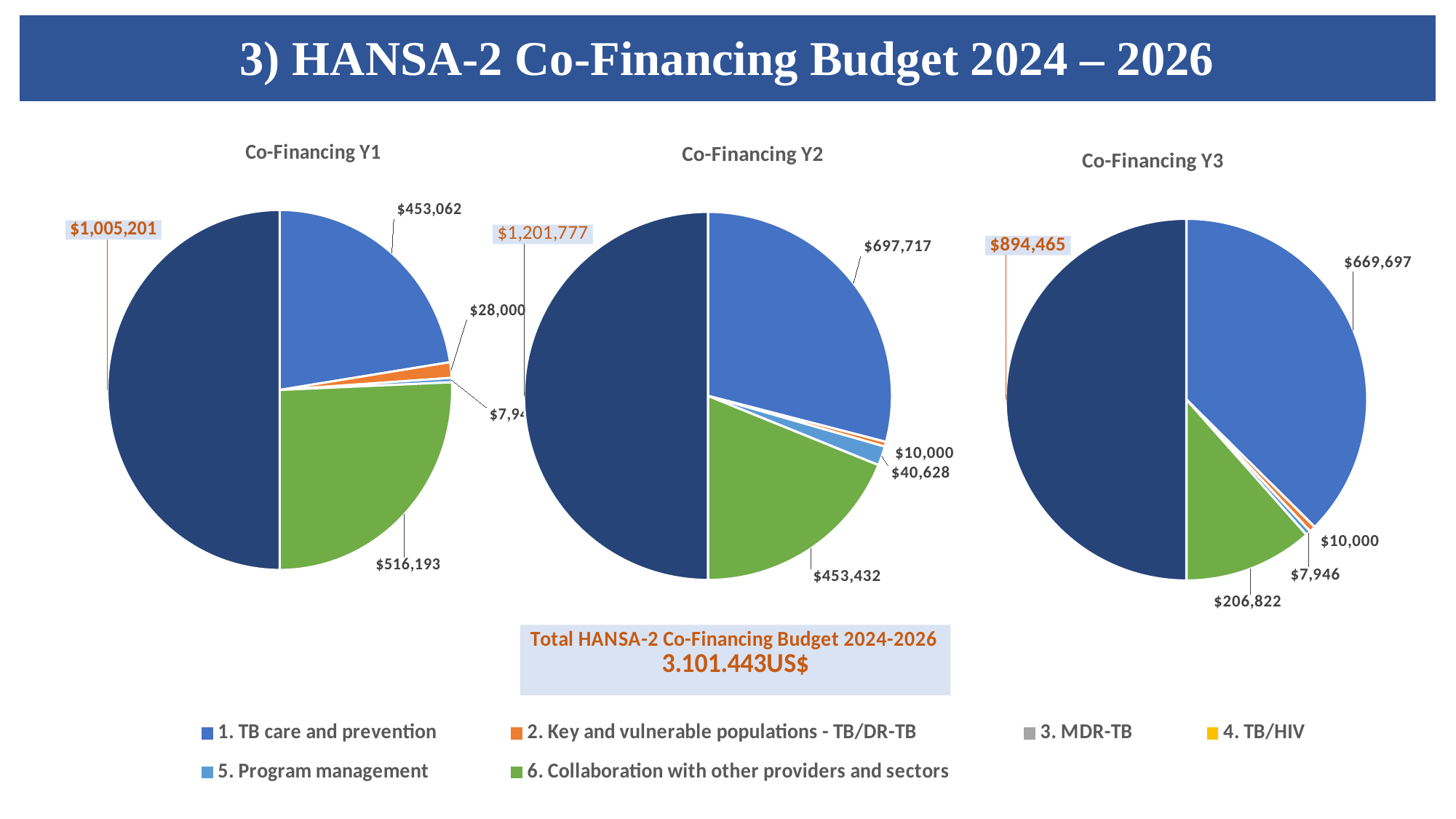
How many pie charts are on the slide? 3 In the Co-Financing Y1 chart, which is larger: the green slice ($516,193) or the medium blue slice ($453,062)? The green slice ($516,193) In the Co-Financing Y3 chart, what is the value of the green slice (6. Collaboration with other providers and sectors)? $206,822 In the Co-Financing Y3 chart, what is the value of the largest slice? $894,465 What is the difference between the green slice ($516,193) and the medium blue slice ($453,062) in the Co-Financing Y1 chart? $63,131 How many entries does the legend list? 6 In the Co-Financing Y2 chart, what is the value of the largest slice? $1,201,777 In the Co-Financing Y1 chart, what is the value of the largest slice? $1,005,201 In the Co-Financing Y2 chart, what is the value of the light blue slice (5. Program management)? $40,628 In the Co-Financing Y1 chart, what is the value of the orange slice (2. Key and vulnerable populations - TB/DR-TB)? $28,000 What kind of charts are shown on the slide? Pie charts What total HANSA-2 Co-Financing Budget 2024-2026 is stated on the slide? 3.101.443US$